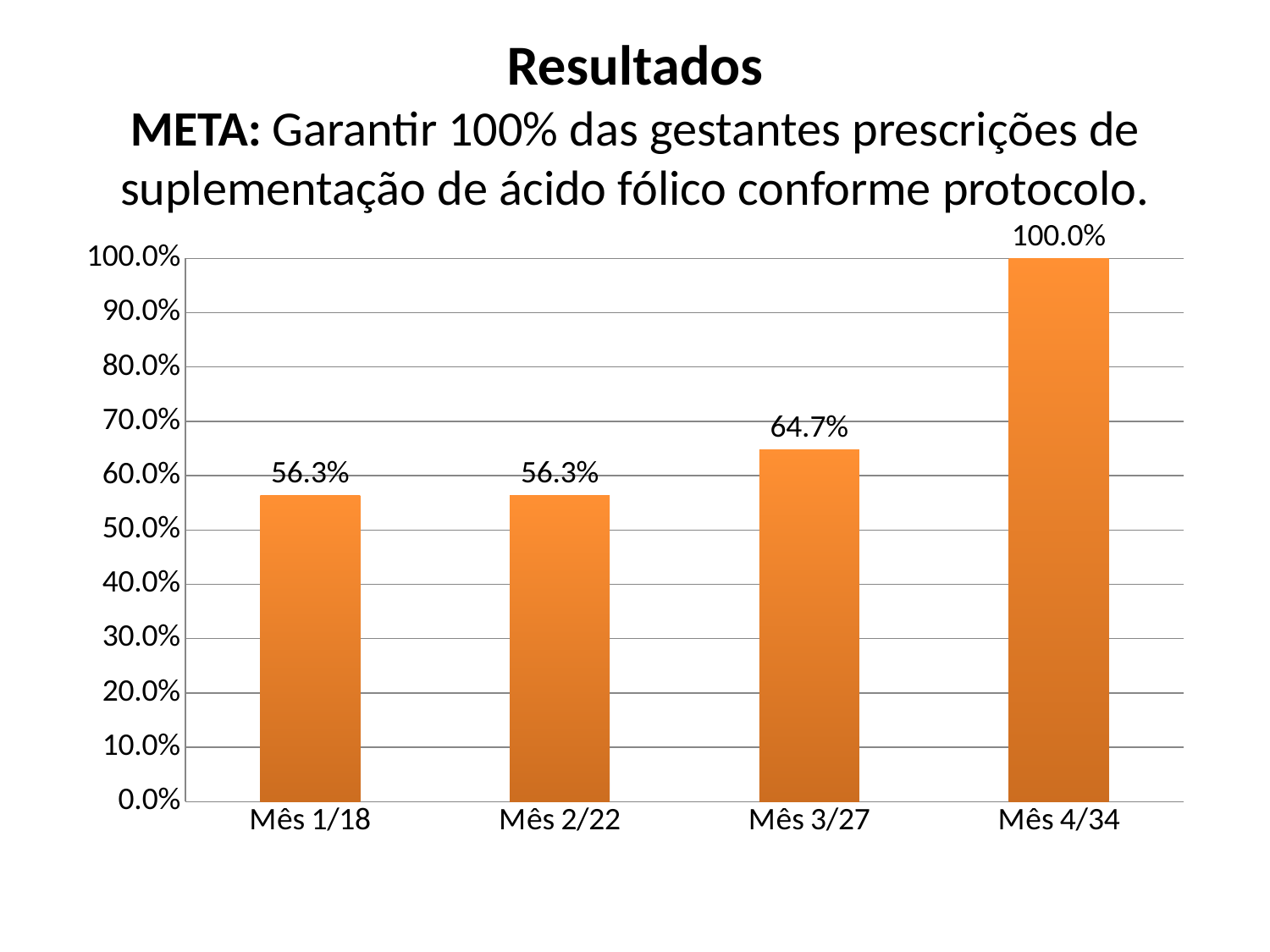
What is the difference between the values for Mês 4/34 and Mês 3/27? 35.3% Which is larger, the value for Mês 3/27 or the value for Mês 1/18? Mês 3/27 Which category has the highest value? Mês 4/34 What is the value for Mês 4/34? 100.0% How many categories are shown on the x axis? 4 What is the value for Mês 1/18? 56.3% What kind of chart is shown on the slide? bar chart Do the values rise or fall from Mês 1/18 to Mês 4/34? rise What is the difference between the values for Mês 3/27 and Mês 2/22? 8.4% Is the value for Mês 2/22 greater or less than 60.0%? less What is the value for Mês 3/27? 64.7% What colour are the bars in the chart? orange